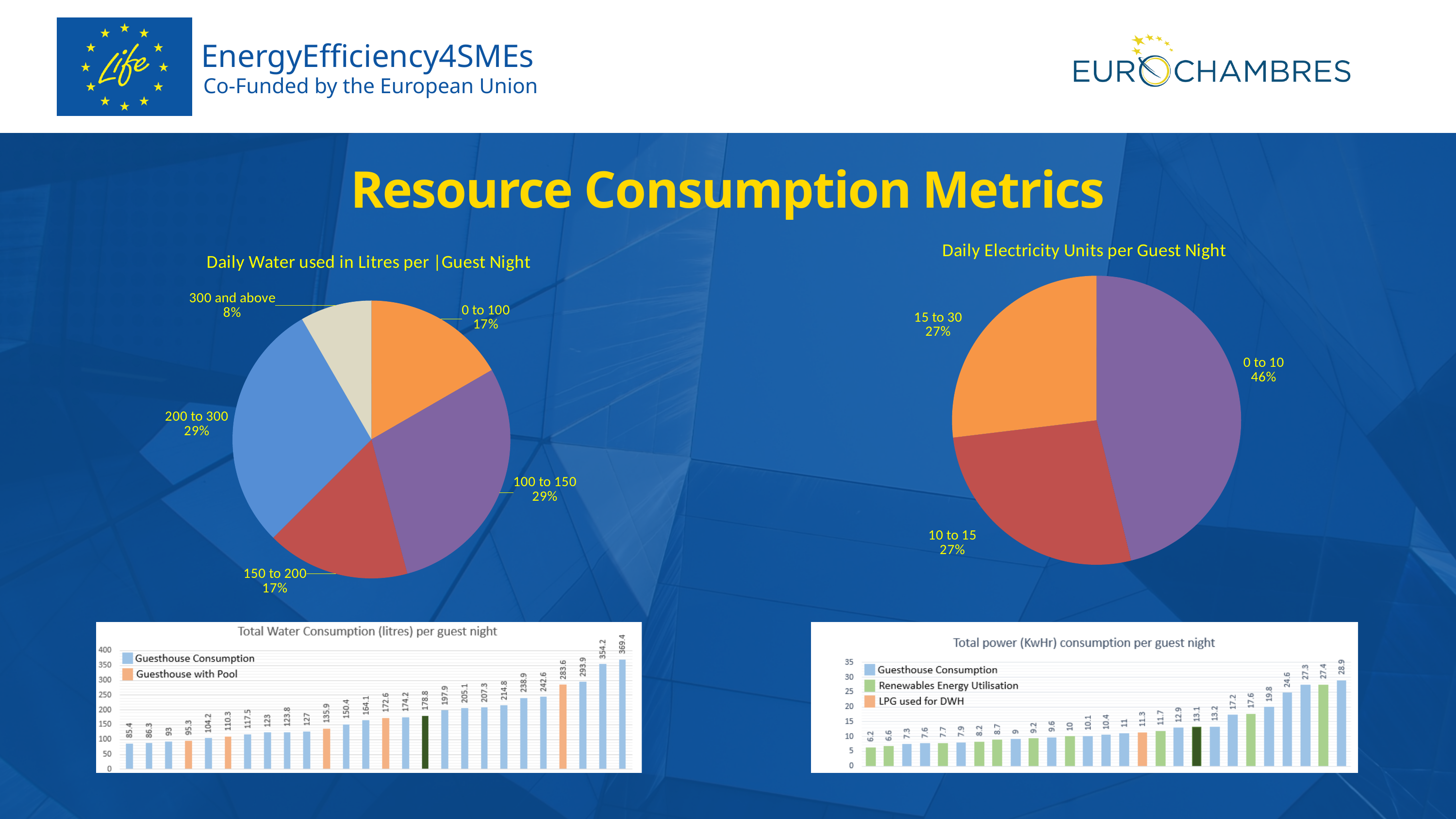
In the 'Total Water Consumption (litres) per guest night' chart, what is the lowest value shown? 85.4 In the 'Total power (KwHr) consumption per guest night' chart, what is the highest value shown? 28.9 What kind of chart is 'Total Water Consumption (litres) per guest night'? bar chart In the 'Total power (KwHr) consumption per guest night' chart, do the values rise or fall from left to right? rise In the 'Daily Electricity Units per Guest Night' pie chart, what share does the '0 to 10' slice have? 46% In the 'Daily Water used in Litres per Guest Night' pie chart, what share does the '200 to 300' slice have? 29% In the 'Total Water Consumption (litres) per guest night' chart, what is the highest value shown? 369.4 How many series does the legend of the 'Total power (KwHr) consumption per guest night' chart list? 3 In the 'Daily Water used in Litres per Guest Night' pie chart, which category has the smallest share? 300 and above In the 'Daily Electricity Units per Guest Night' pie chart, what is the difference in percentage points between the '0 to 10' slice and the '15 to 30' slice? 19 In the 'Daily Electricity Units per Guest Night' pie chart, which category has the largest share? 0 to 10 In the 'Daily Water used in Litres per Guest Night' pie chart, how many slices are there? 5